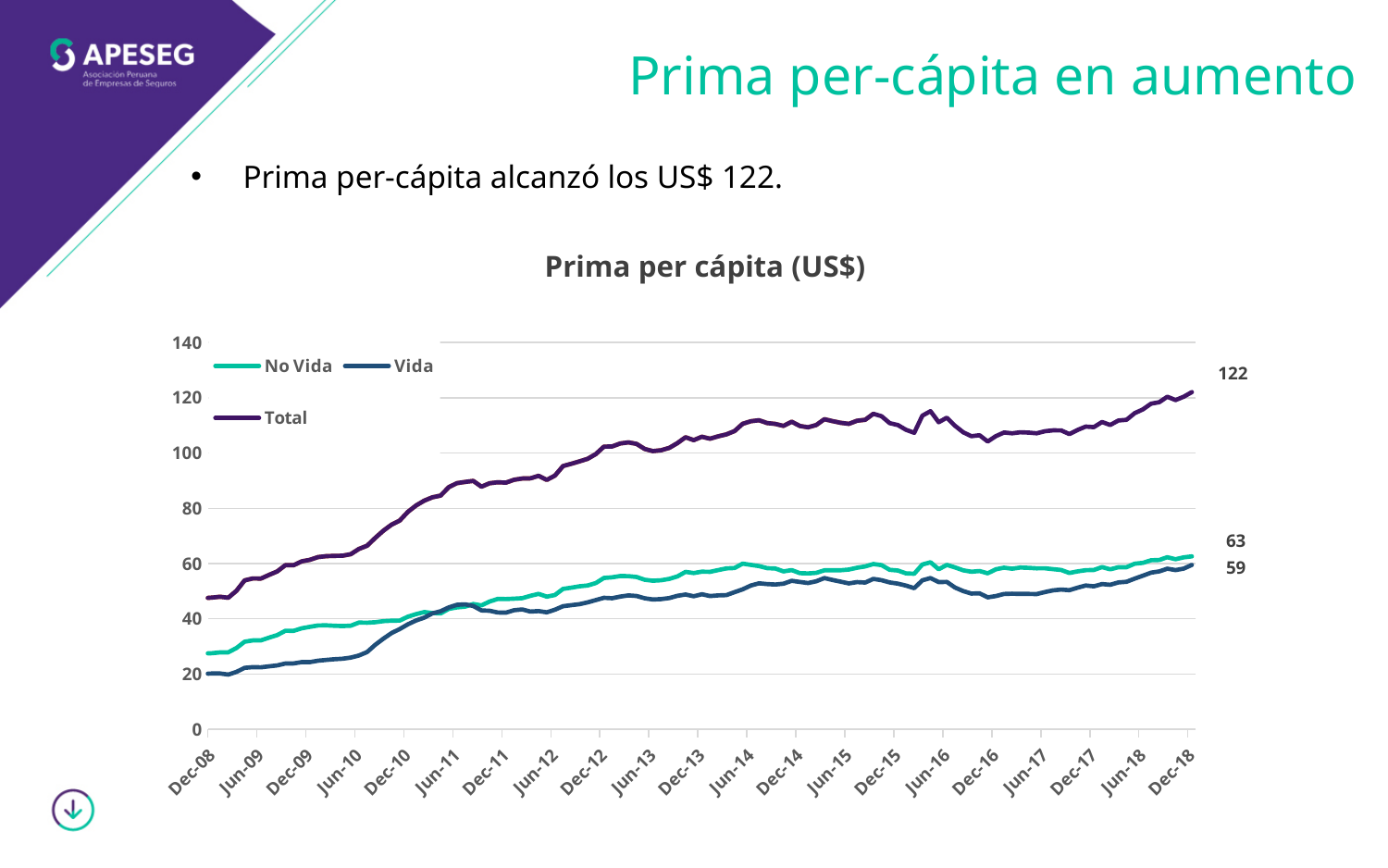
At Dec-18, how much higher is the Total value than the No Vida value? 59 What kind of chart is shown on the slide? line chart What is the value of the Vida series at Dec-18? 59 At Dec-18, which series has the larger value, No Vida or Vida? No Vida What is the value of the No Vida series at Dec-18? 63 Which series has the highest value at Dec-18? Total Is the value of the Total series at Dec-08 greater or less than 60? less At Dec-18, what is the difference between the No Vida value and the Vida value? 4 Does the Total series generally rise or fall from Dec-08 to Dec-18? rise What is the value of the Total series at Dec-18? 122 What is the title of the chart? Prima per cápita (US$) How many series does the legend of the chart list? 3